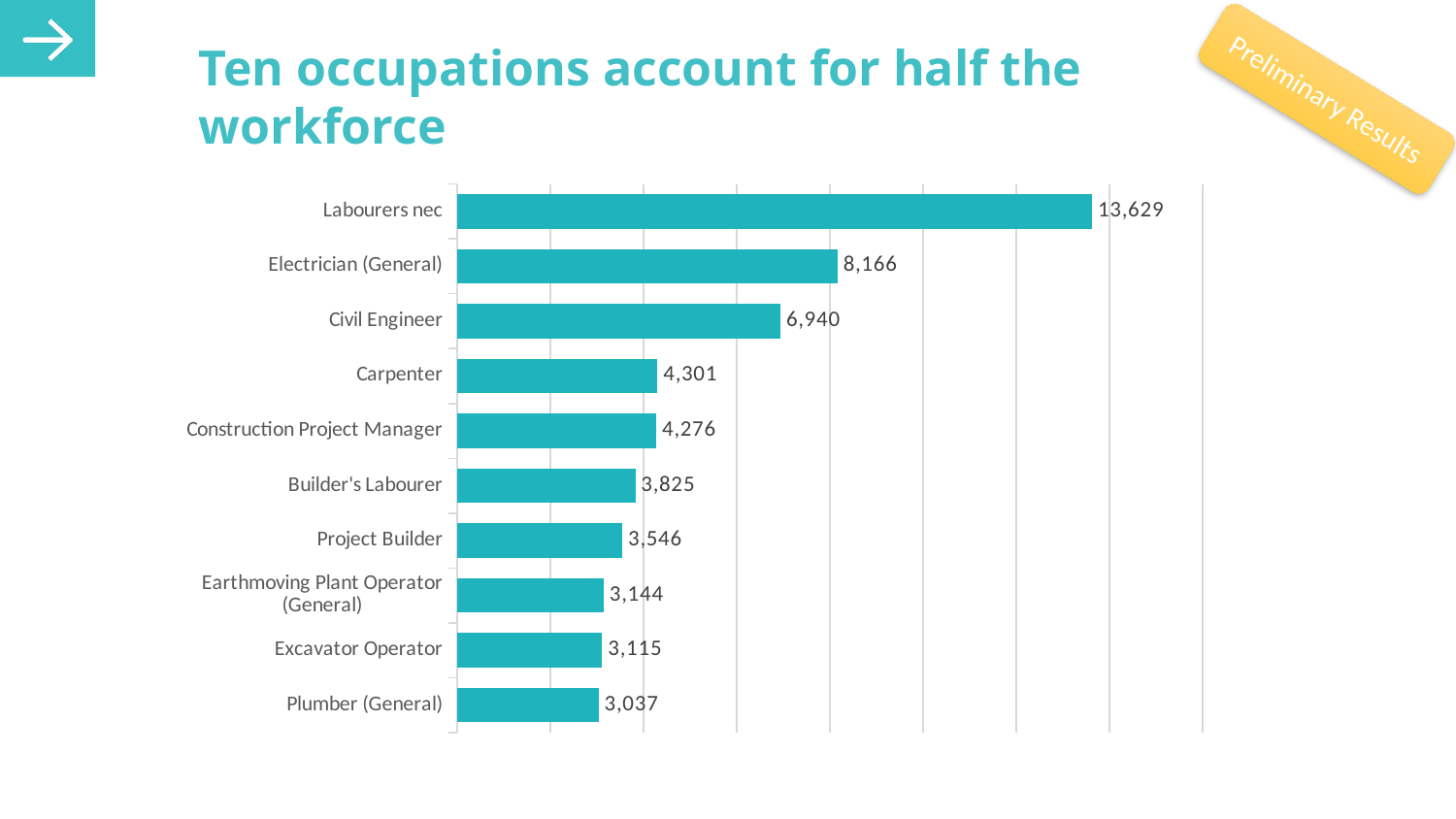
What is the value for Excavator Operator? 3,115 What is the value for Civil Engineer? 6,940 What is the difference between the values for Electrician (General) and Civil Engineer? 1,226 What kind of chart is shown on the slide? Bar chart Which occupation has the lowest value? Plumber (General) What is the difference between the values for Carpenter and Construction Project Manager? 25 How many occupations are shown in the chart? 10 Which is larger, the value for Builder's Labourer or the value for Project Builder? Builder's Labourer Which occupation has the highest value? Labourers nec What is the value for Labourers nec? 13,629 What is the value for Earthmoving Plant Operator (General)? 3,144 What is the title of the slide? Ten occupations account for half the workforce